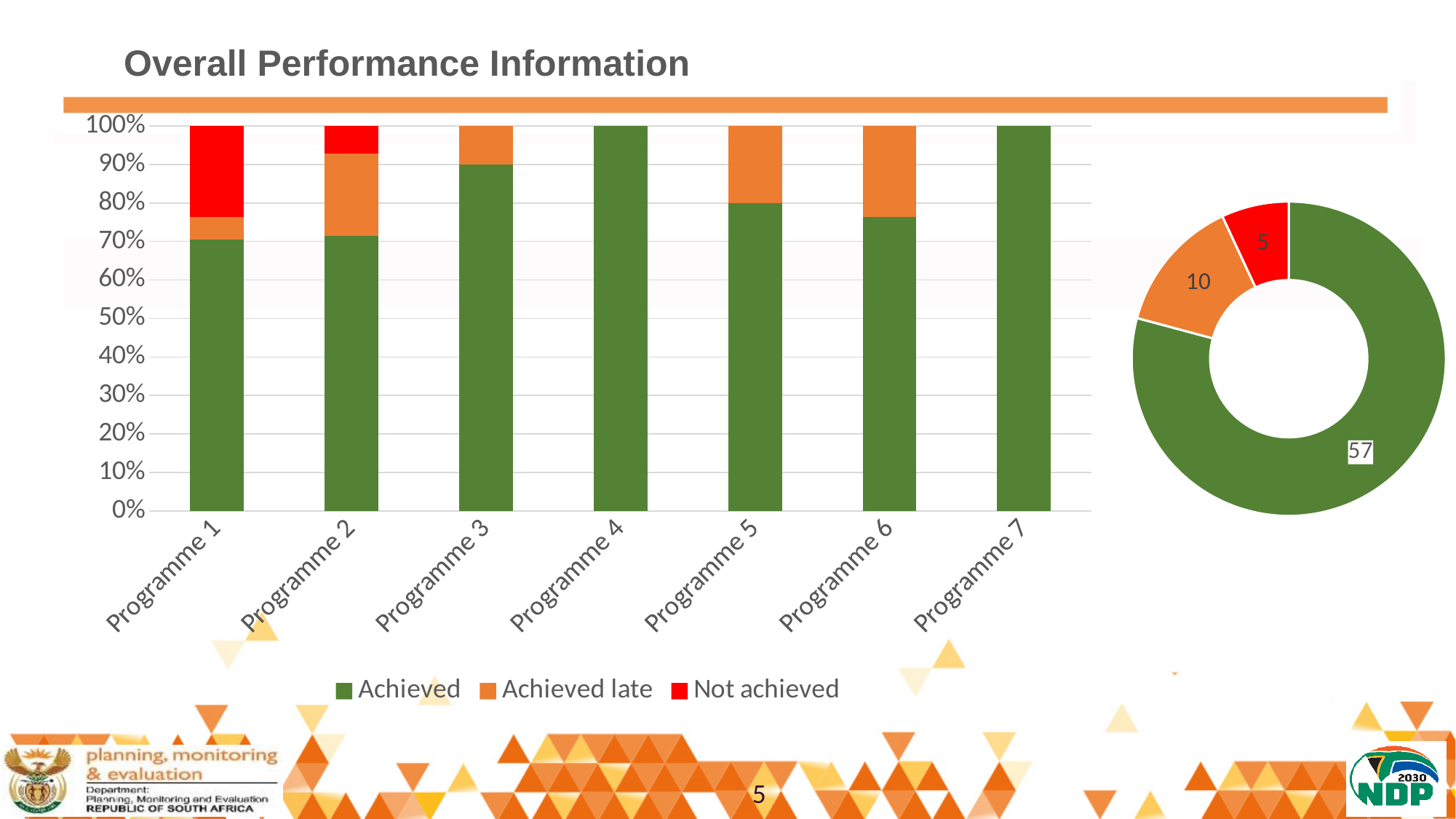
In the bar chart, what is the Achieved value for Programme 3? 90% In the doughnut chart, what is the value of the smallest slice? 5 In the bar chart, is the Not achieved value for Programme 1 greater or less than 20%? greater In the bar chart, what is the Achieved value for Programme 5? 80% What kind of chart is the chart on the right of the slide? Doughnut chart In the bar chart, is the Achieved value for Programme 6 greater or less than 70%? greater In the doughnut chart, what is the value of the largest slice? 57 What kind of chart is the chart on the left of the slide? Stacked bar chart In the bar chart, what is the Achieved value for Programme 4? 100% In the doughnut chart, what is the difference between the green slice (57) and the orange slice (10)? 47 How many series does the legend of the bar chart list? 3 In the bar chart, how many programmes are shown on the x axis? 7